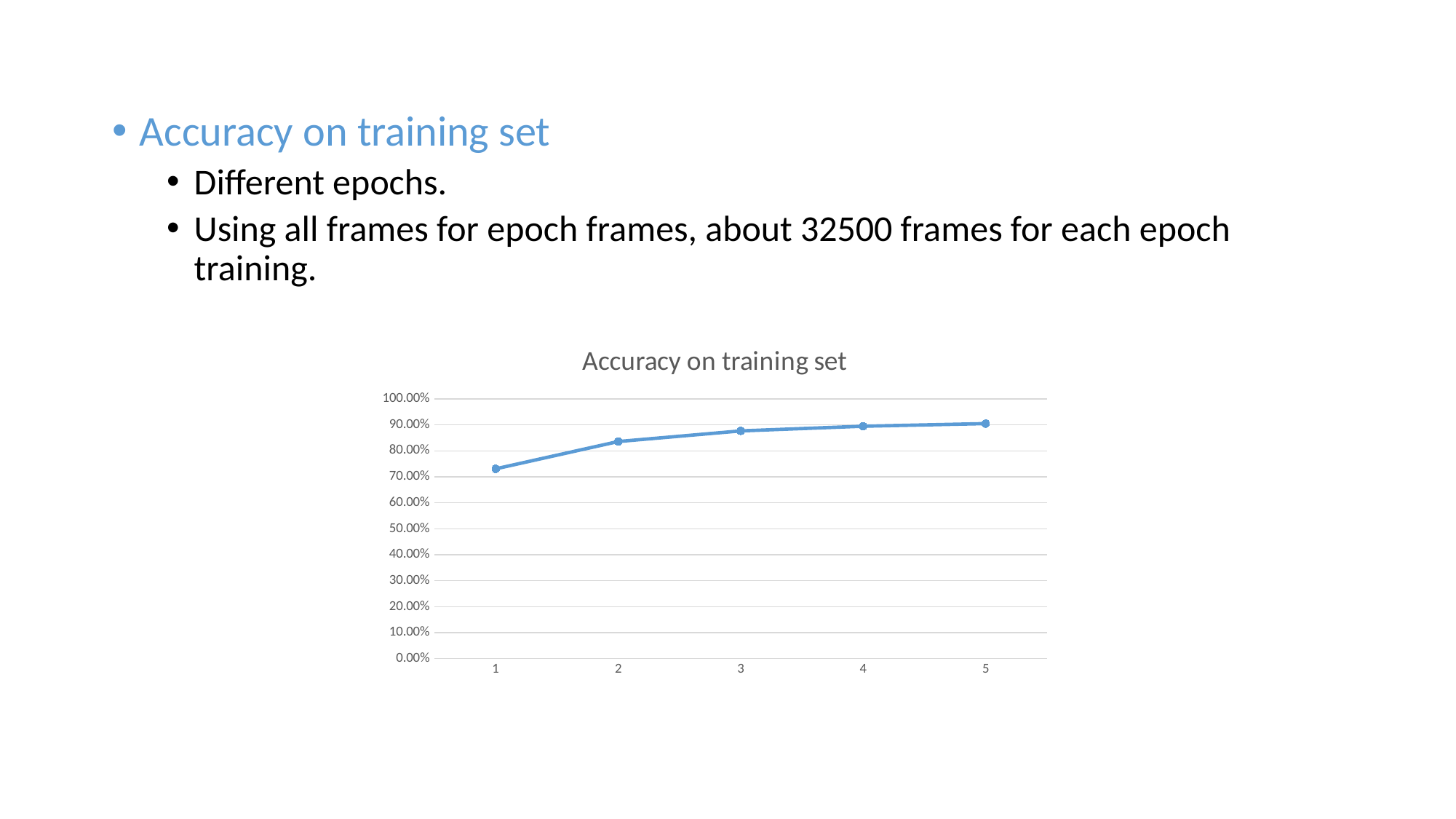
Which epoch has the lowest accuracy on the training set? 1 Is the value for epoch 3 greater or less than 90.00%? less What kind of chart is shown on the slide? line chart Is the value for epoch 1 greater or less than 70.00%? greater Do the values rise or fall as the epoch number increases from 1 to 5? rise How many data points are plotted on the line? 5 Which epoch has the highest accuracy on the training set? 5 Is the value for epoch 2 greater or less than 80.00%? greater What is the highest value shown on the y axis? 100.00% Which has the larger value, epoch 1 or epoch 2? epoch 2 What is the title of the chart? Accuracy on training set